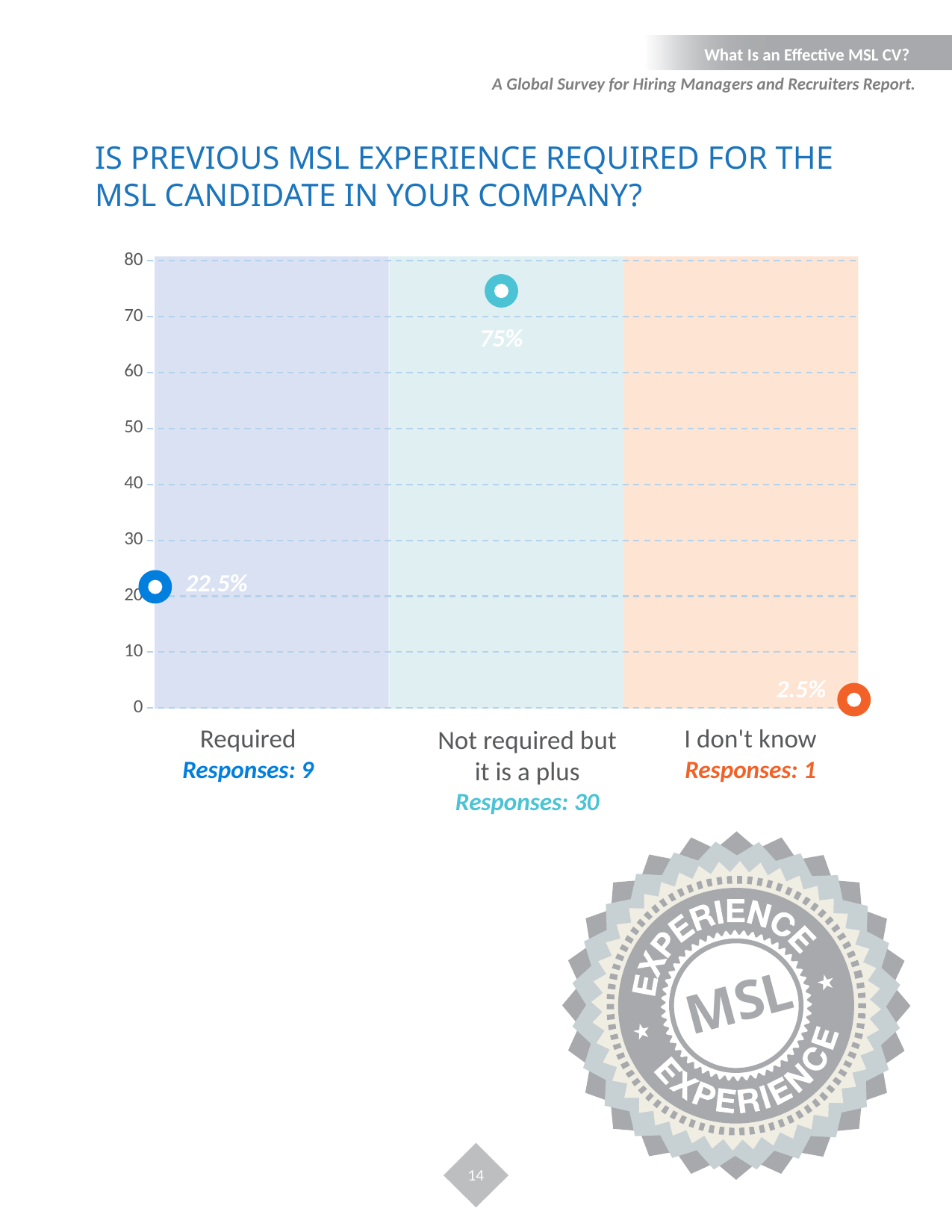
What is the highest value shown on the vertical axis? 80 What percentage is shown for 'I don't know'? 2.5% How many responses are listed for the 'Required' category? 9 Which is larger, the percentage for 'Required' or for 'I don't know'? Required How many categories are plotted on the chart? 3 Which category has the lowest percentage? I don't know How many responses are listed for 'Not required but it is a plus'? 30 What percentage is shown for the 'Required' category? 22.5% What is the difference in percentage points between 'Not required but it is a plus' and 'Required'? 52.5 What percentage is shown for 'Not required but it is a plus'? 75% What is the total number of responses across all three categories? 40 Which category has the highest percentage? Not required but it is a plus